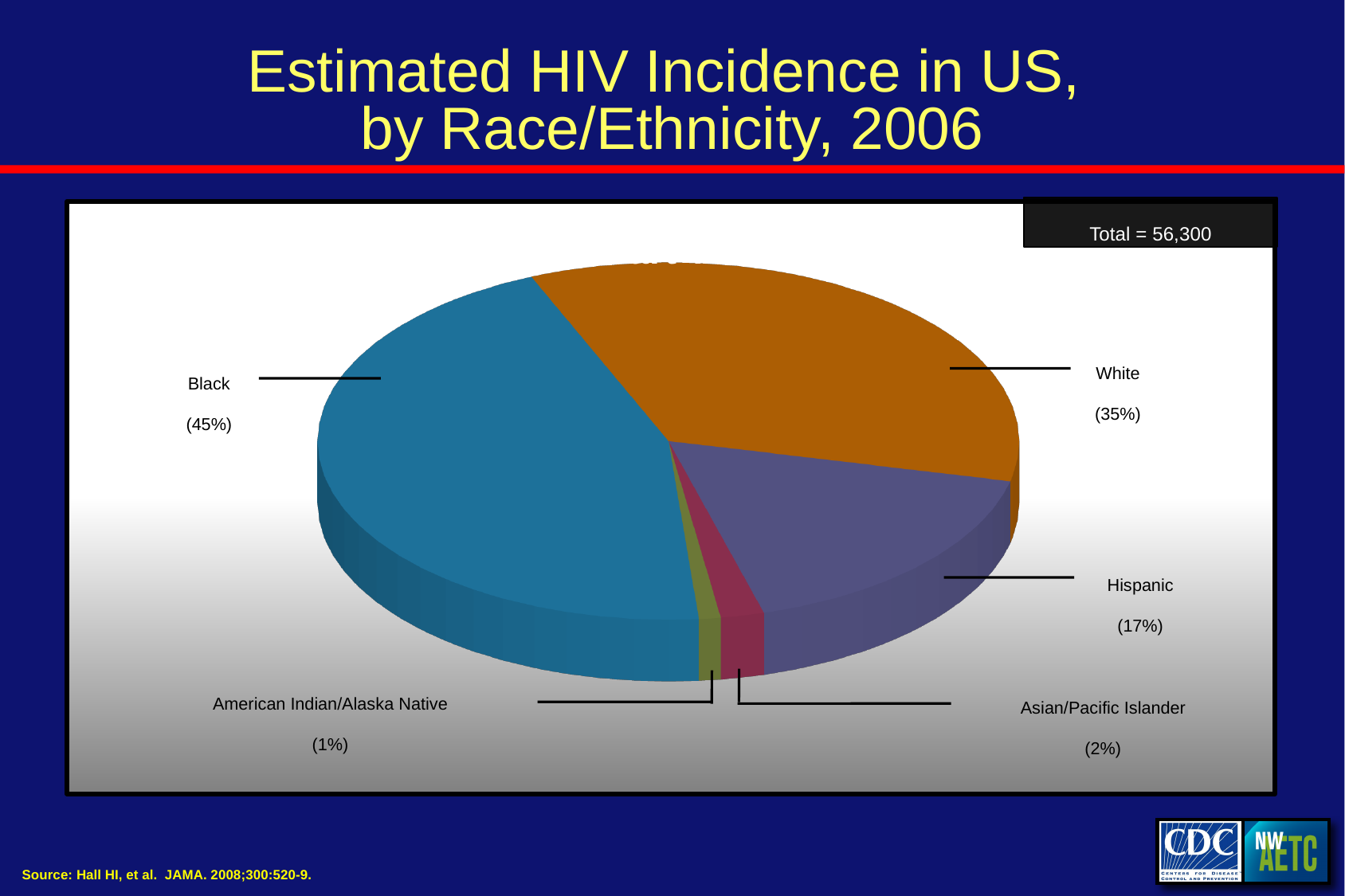
What total number of estimated HIV incidence cases is stated on the chart? 56,300 What kind of chart is shown on the slide? Pie chart Which race/ethnicity group has the smallest share of the pie? American Indian/Alaska Native How many percentage points larger is the Black share than the White share? 10 Which group has a larger share, Hispanic or White? White Which race/ethnicity group has the largest share of the pie? Black What share of estimated HIV incidence is attributed to Black individuals? 45% How many race/ethnicity categories are shown in the pie chart? 5 What share of estimated HIV incidence is attributed to American Indian/Alaska Native individuals? 1% What share of estimated HIV incidence is attributed to Hispanic individuals? 17%